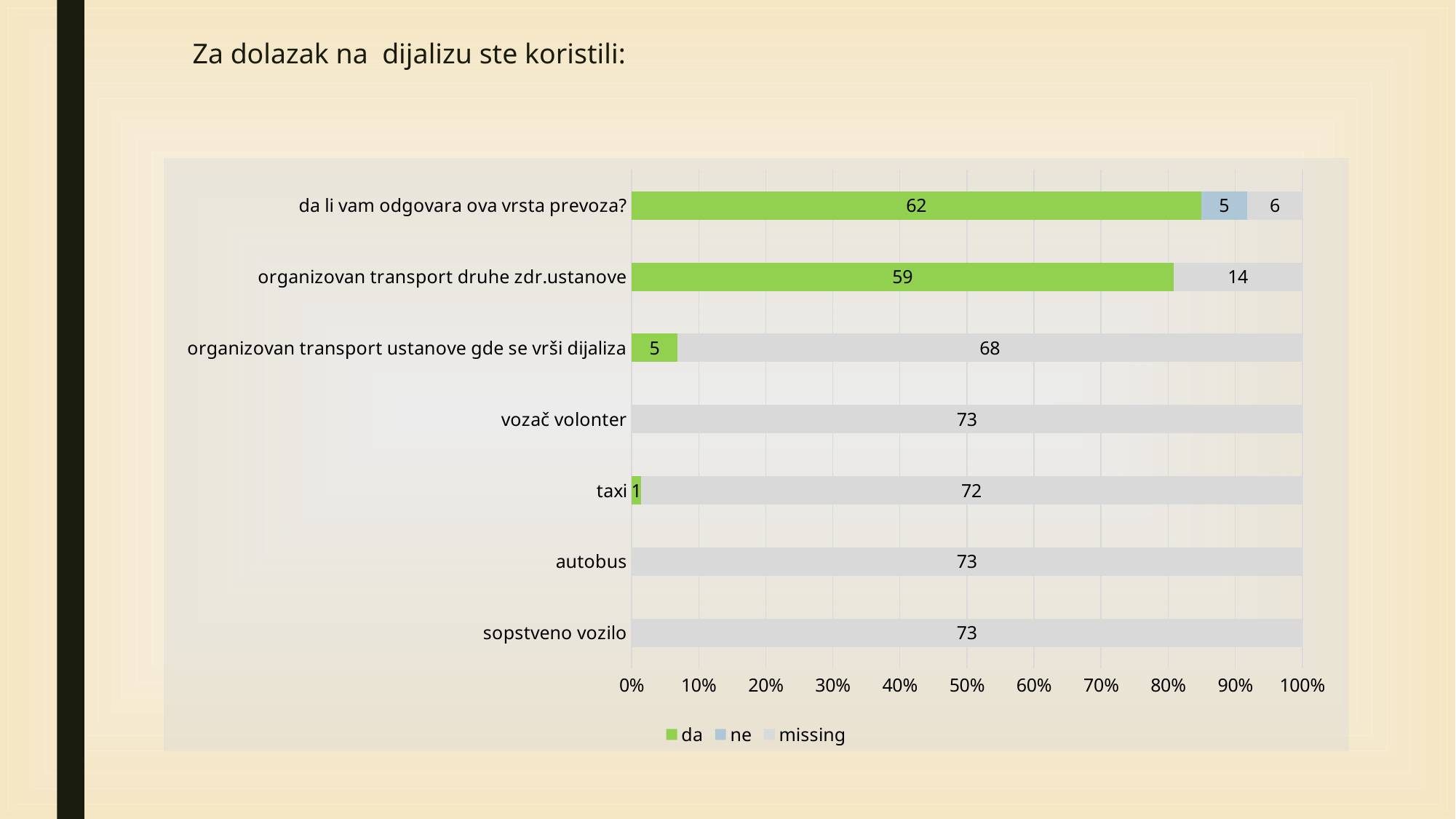
How many categories are shown on the chart? 7 What is the title of the slide? Za dolazak na dijalizu ste koristili: What is the difference between the 'da' values for 'da li vam odgovara ova vrsta prevoza?' and 'organizovan transport druhe zdr.ustanove'? 3 What is the 'da' value for 'organizovan transport druhe zdr.ustanove'? 59 What is the 'missing' value for 'organizovan transport ustanove gde se vrši dijaliza'? 68 What is the total of the stacked bar for 'da li vam odgovara ova vrsta prevoza?'? 73 Which category has the highest 'da' value? da li vam odgovara ova vrsta prevoza? What kind of chart is shown on the slide? Stacked bar chart What is the 'ne' value for 'da li vam odgovara ova vrsta prevoza?'? 5 What is the 'da' value for 'taxi'? 1 Which is larger: the 'missing' value for 'organizovan transport druhe zdr.ustanove' or for 'organizovan transport ustanove gde se vrši dijaliza'? organizovan transport ustanove gde se vrši dijaliza How many series does the legend list? 3